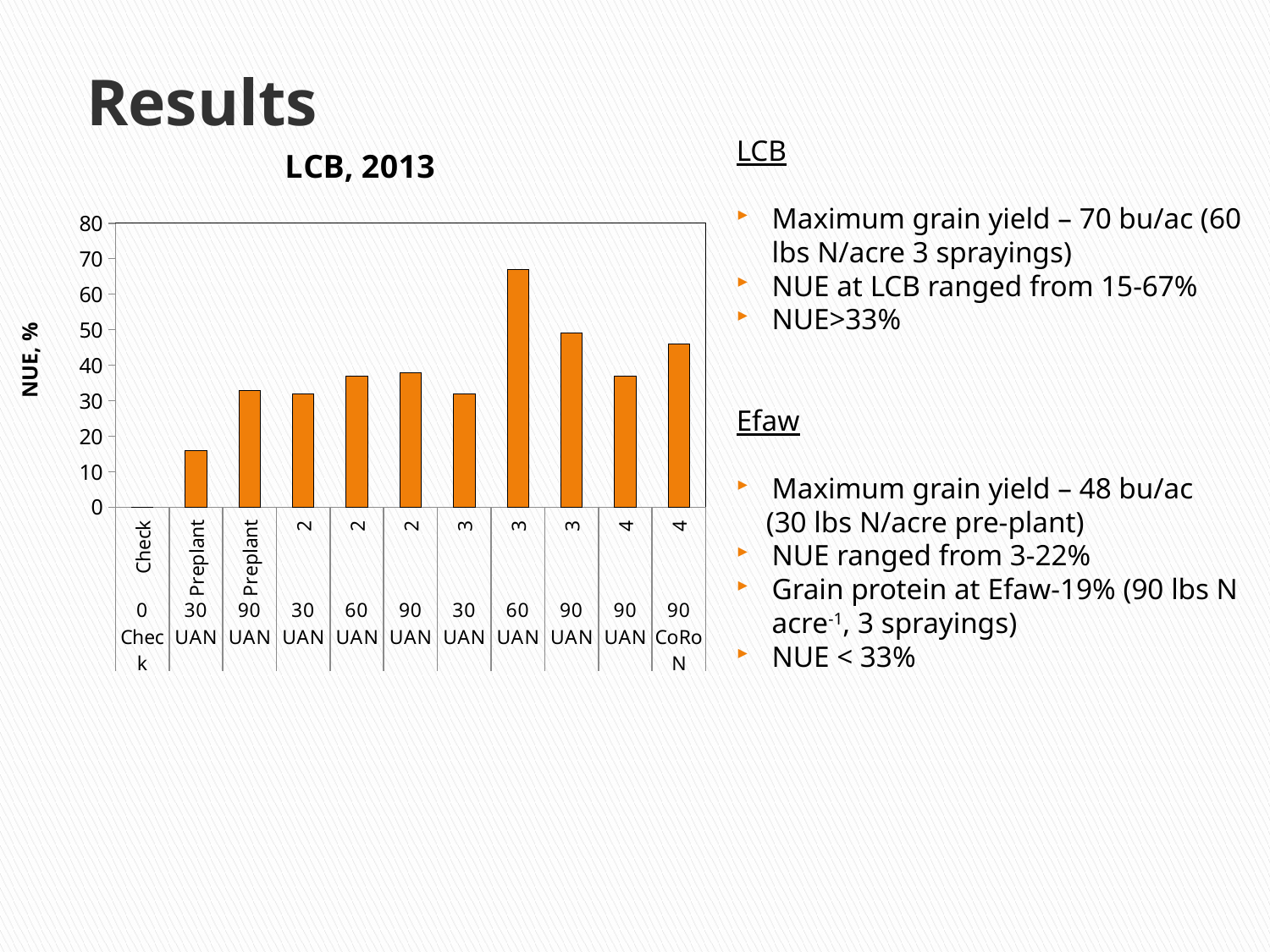
What is the label on the vertical axis of the chart? NUE, % Is the NUE value for 60 UAN with 3 sprayings greater or less than 60? greater Is the NUE value for 90 CoRoN with 4 sprayings greater or less than 40? greater Which treatment has the highest NUE in the chart? 60 UAN, 3 sprayings What is the title of the chart? LCB, 2013 What kind of chart is shown on the slide? bar chart Which treatment has the lowest NUE in the chart? 0 Check Which has a higher NUE: 60 UAN with 3 sprayings or 90 UAN with 3 sprayings? 60 UAN with 3 sprayings Is the NUE value for 30 UAN Preplant greater or less than 20? less How many categories (bars) are shown on the x axis of the chart? 11 Which has a higher NUE: 90 UAN with 4 sprayings or 90 CoRoN with 4 sprayings? 90 CoRoN with 4 sprayings